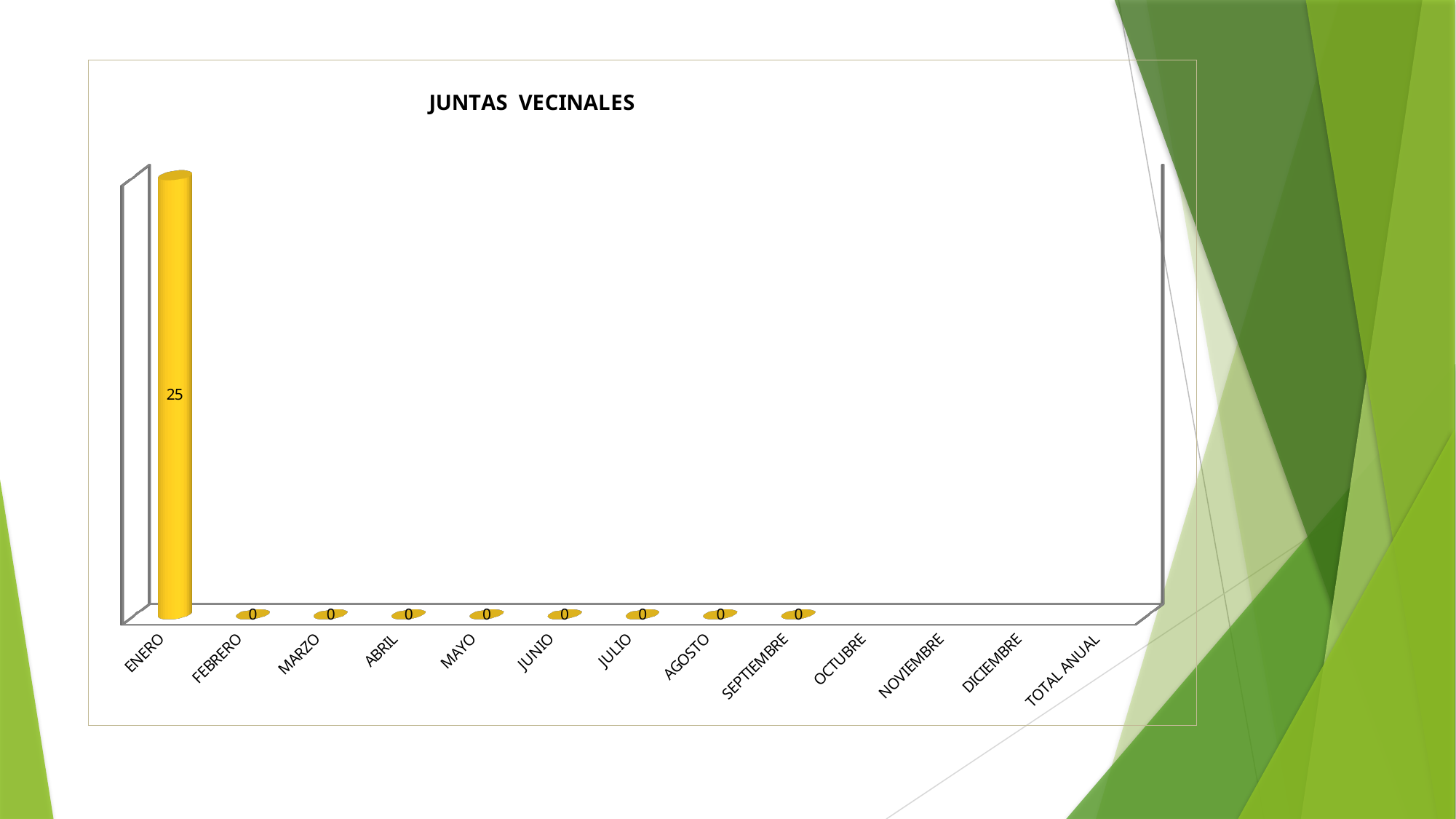
How many category labels are shown on the x axis? 13 What kind of chart is this? bar chart Do the values rise or fall from ENERO to FEBRERO? fall What is the difference between the values for ENERO and MARZO? 25 What is the value for ENERO? 25 What is the title of the chart? JUNTAS VECINALES What colour are the bars in the chart? yellow What is the value for FEBRERO? 0 Which month has the highest value? ENERO Which is larger, the value for ENERO or the value for JULIO? ENERO What is the value for SEPTIEMBRE? 0 What is the value for AGOSTO? 0